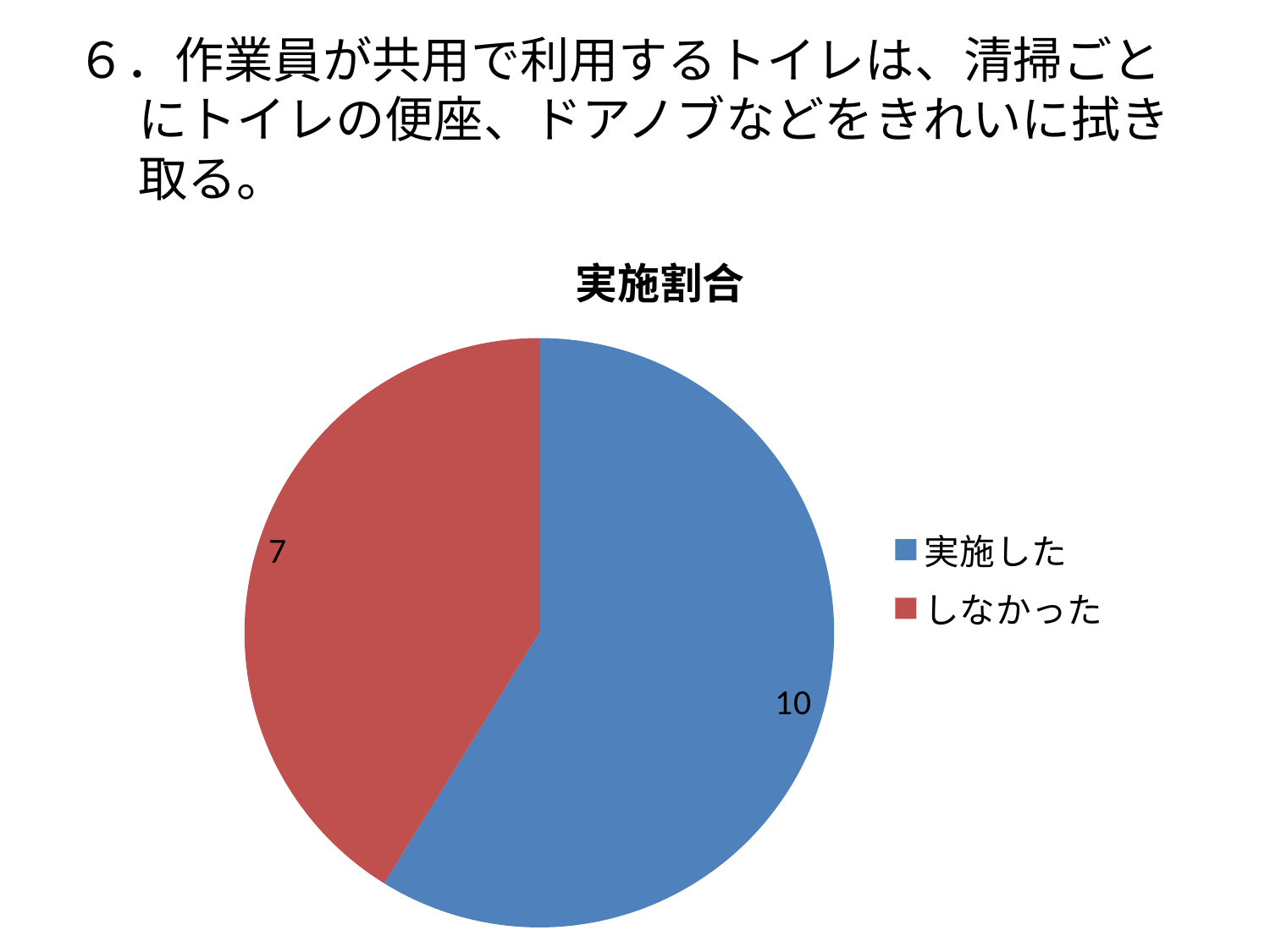
What is the value for しなかった? 7 Which category has the largest slice? 実施した What kind of chart is shown on the slide? pie chart What is the difference between the values for 実施した and しなかった? 3 What colour is the slice for しなかった? red What is the value for 実施した? 10 How many slices does the pie chart have? 2 Which is larger, the value for 実施した or the value for しなかった? 実施した How many entries does the legend list? 2 What is the title of the chart? 実施割合 What is the total of all slices in the pie chart? 17 Which category has the smallest slice? しなかった